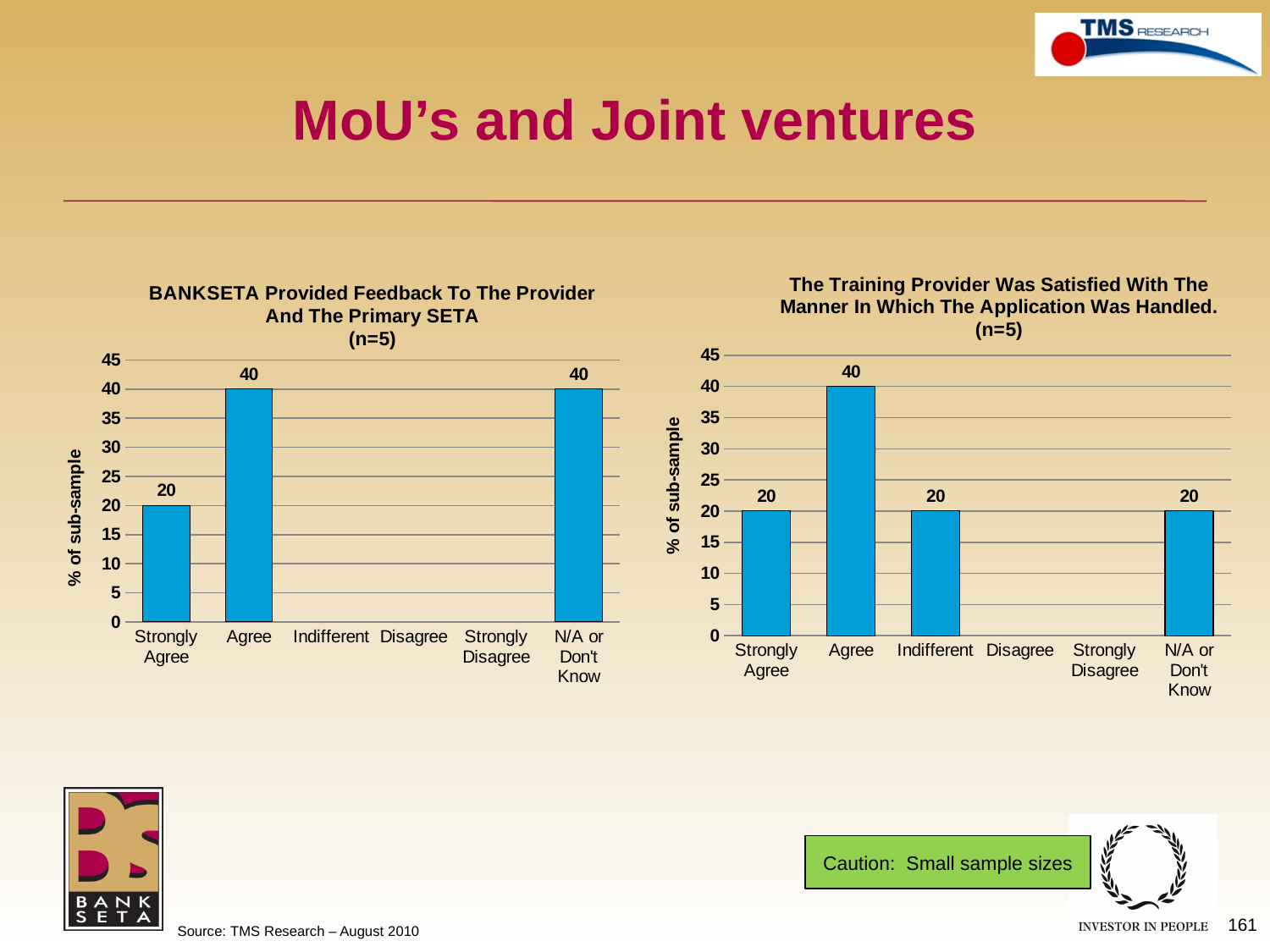
In the right chart (The Training Provider Was Satisfied With The Manner In Which The Application Was Handled), which category has the highest value? Agree What is the y-axis label of the left chart (BANKSETA Provided Feedback To The Provider And The Primary SETA)? % of sub-sample In the right chart (The Training Provider Was Satisfied With The Manner In Which The Application Was Handled), which is larger, the value for Agree or the value for Strongly Agree? Agree What sample size (n) is shown in the title of the right chart (The Training Provider Was Satisfied With The Manner In Which The Application Was Handled)? n=5 In the left chart (BANKSETA Provided Feedback To The Provider And The Primary SETA), what is the difference between the values for Agree and Strongly Agree? 20 What kind of chart is the right chart (The Training Provider Was Satisfied With The Manner In Which The Application Was Handled)? Bar chart In the left chart (BANKSETA Provided Feedback To The Provider And The Primary SETA), what is the value for Strongly Agree? 20 In the left chart (BANKSETA Provided Feedback To The Provider And The Primary SETA), how many categories are shown on the x axis? 6 In the right chart (The Training Provider Was Satisfied With The Manner In Which The Application Was Handled), what is the value for N/A or Don't Know? 20 In the left chart (BANKSETA Provided Feedback To The Provider And The Primary SETA), is the value for N/A or Don't Know greater or less than 30? greater In the left chart (BANKSETA Provided Feedback To The Provider And The Primary SETA), what is the value for Agree? 40 In the right chart (The Training Provider Was Satisfied With The Manner In Which The Application Was Handled), what is the value for Indifferent? 20